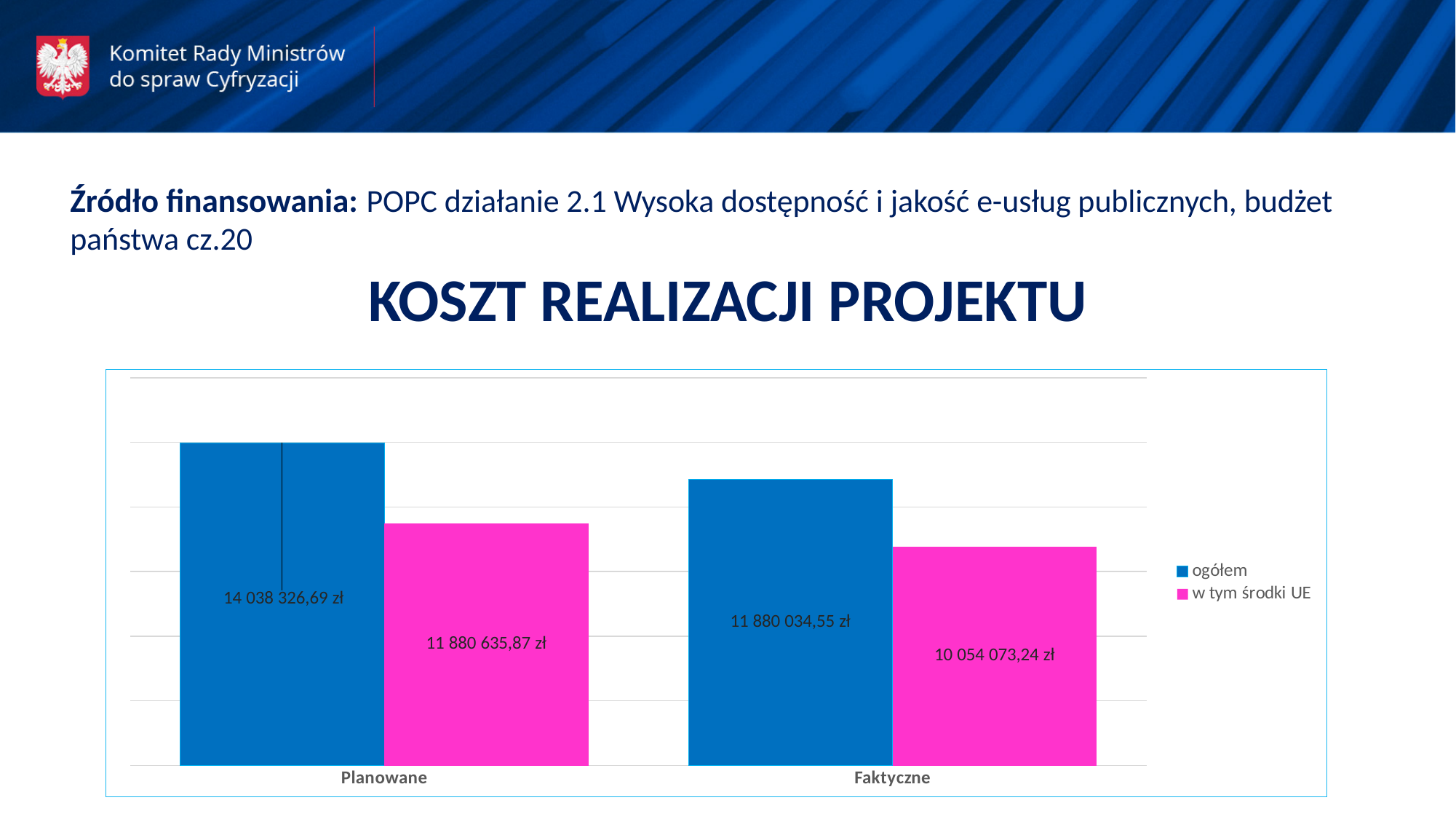
Is the 'ogółem' value larger for Planowane or for Faktyczne? Planowane Which bar has the lowest value in the chart? w tym środki UE for Faktyczne Which bar has the highest value in the chart? ogółem for Planowane What is the value of 'ogółem' for Faktyczne? 11 880 034,55 zł What is the value of 'w tym środki UE' for Planowane? 11 880 635,87 zł What is the difference between 'ogółem' and 'w tym środki UE' for Planowane? 2 157 690,82 zł What is the value of 'ogółem' for Planowane? 14 038 326,69 zł How many series does the legend list? 2 What is the title of the chart? KOSZT REALIZACJI PROJEKTU What is the value of 'w tym środki UE' for Faktyczne? 10 054 073,24 zł How many categories are shown on the x axis? 2 What type of chart is shown on the slide? Bar chart